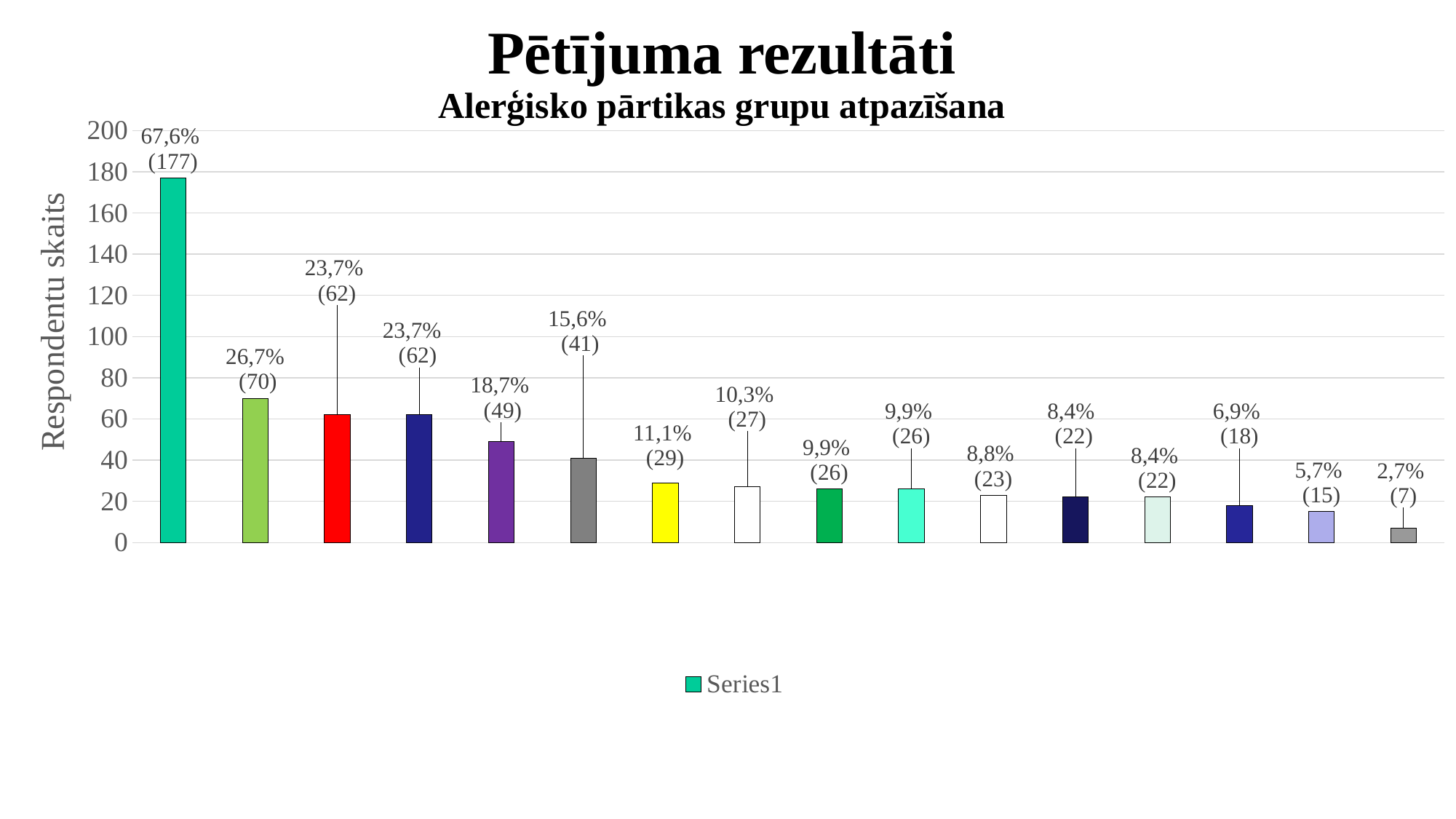
How many series does the legend list? 1 Which is larger: the respondent count of the yellow bar (seventh) or the purple bar (fifth)? the purple bar (49) What is the respondent count shown on the red bar (third from the left)? 62 Do the bar values generally rise or fall from left to right along the x axis? fall What percentage is shown on the tallest (first) bar? 67,6% What is the title of the vertical axis? Respondentu skaits What is the respondent count shown on the tallest (first) bar? 177 How many bars are plotted in the chart? 16 What is the difference in respondent count between the first bar (177) and the second bar (70)? 107 What percentage is shown on the last bar on the right? 2,7% What kind of chart is shown on the slide? bar chart What is the respondent count shown on the shortest (last) bar? 7